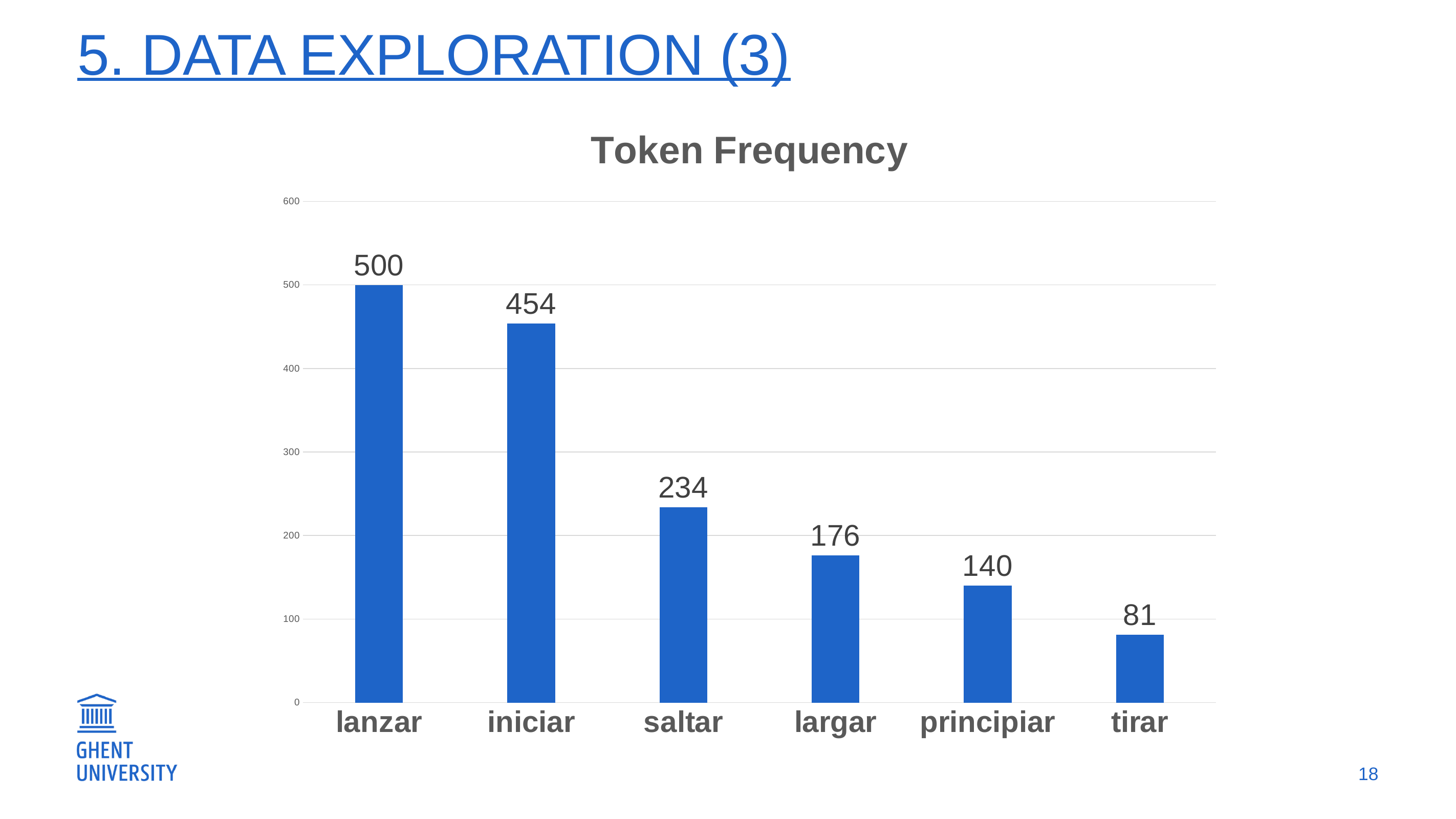
What is the difference in frequency between lanzar and iniciar? 46 What is the difference in frequency between largar and principiar? 36 What kind of chart is shown on the slide? bar chart Which token has the highest frequency? lanzar Which token has the lowest frequency? tirar What is the token frequency for tirar? 81 Is the value for iniciar greater or less than 400? greater Which has a higher frequency, saltar or largar? saltar How many tokens are shown on the chart? 6 What is the title of the chart? Token Frequency What is the token frequency for saltar? 234 What is the token frequency for lanzar? 500